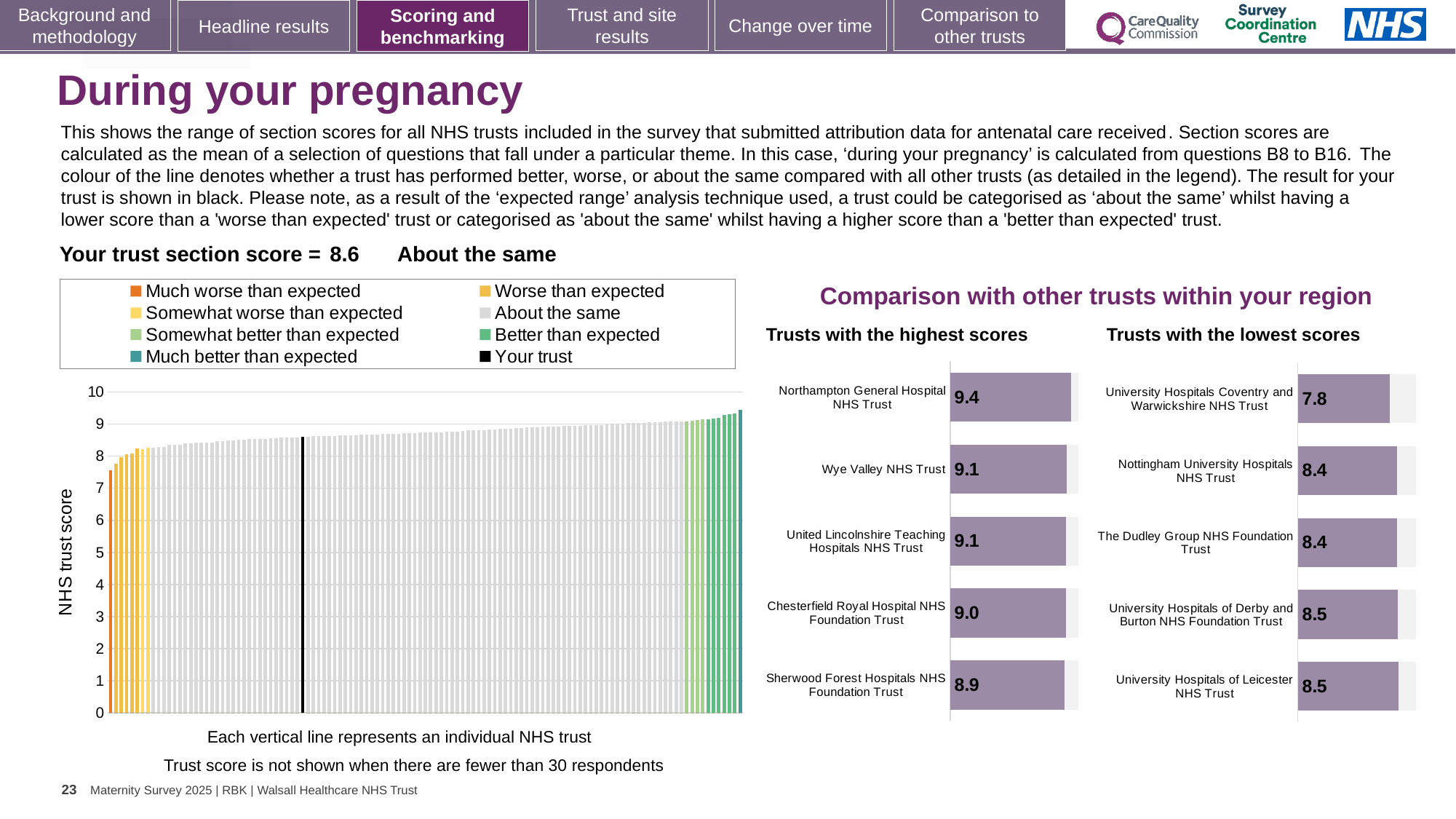
In the 'Trusts with the lowest scores' chart, what is the score for University Hospitals Coventry and Warwickshire NHS Trust? 7.8 In the 'Trusts with the highest scores' chart, what is the difference between the scores of Northampton General Hospital NHS Trust and Sherwood Forest Hospitals NHS Foundation Trust? 0.5 How many trusts are shown in the 'Trusts with the highest scores' chart? 5 In the large chart on the left showing NHS trust scores, do the values rise or fall from left to right? rise In the 'Trusts with the highest scores' chart, what is the score for Northampton General Hospital NHS Trust? 9.4 In the large chart on the left showing NHS trust scores, is the value for the lowest (leftmost) trust greater or less than 8? less What type of chart is the 'Trusts with the lowest scores' chart? bar chart In the 'Trusts with the lowest scores' chart, which trust has the lowest score? University Hospitals Coventry and Warwickshire NHS Trust In the 'Trusts with the highest scores' chart, which trust has the lowest score? Sherwood Forest Hospitals NHS Foundation Trust In the 'Trusts with the lowest scores' chart, what is the difference between the scores of University Hospitals of Derby and Burton NHS Foundation Trust and University Hospitals Coventry and Warwickshire NHS Trust? 0.7 How many entries does the legend of the large chart on the left list? 8 In the 'Trusts with the lowest scores' chart, which has the higher score: Nottingham University Hospitals NHS Trust or University Hospitals of Leicester NHS Trust? University Hospitals of Leicester NHS Trust